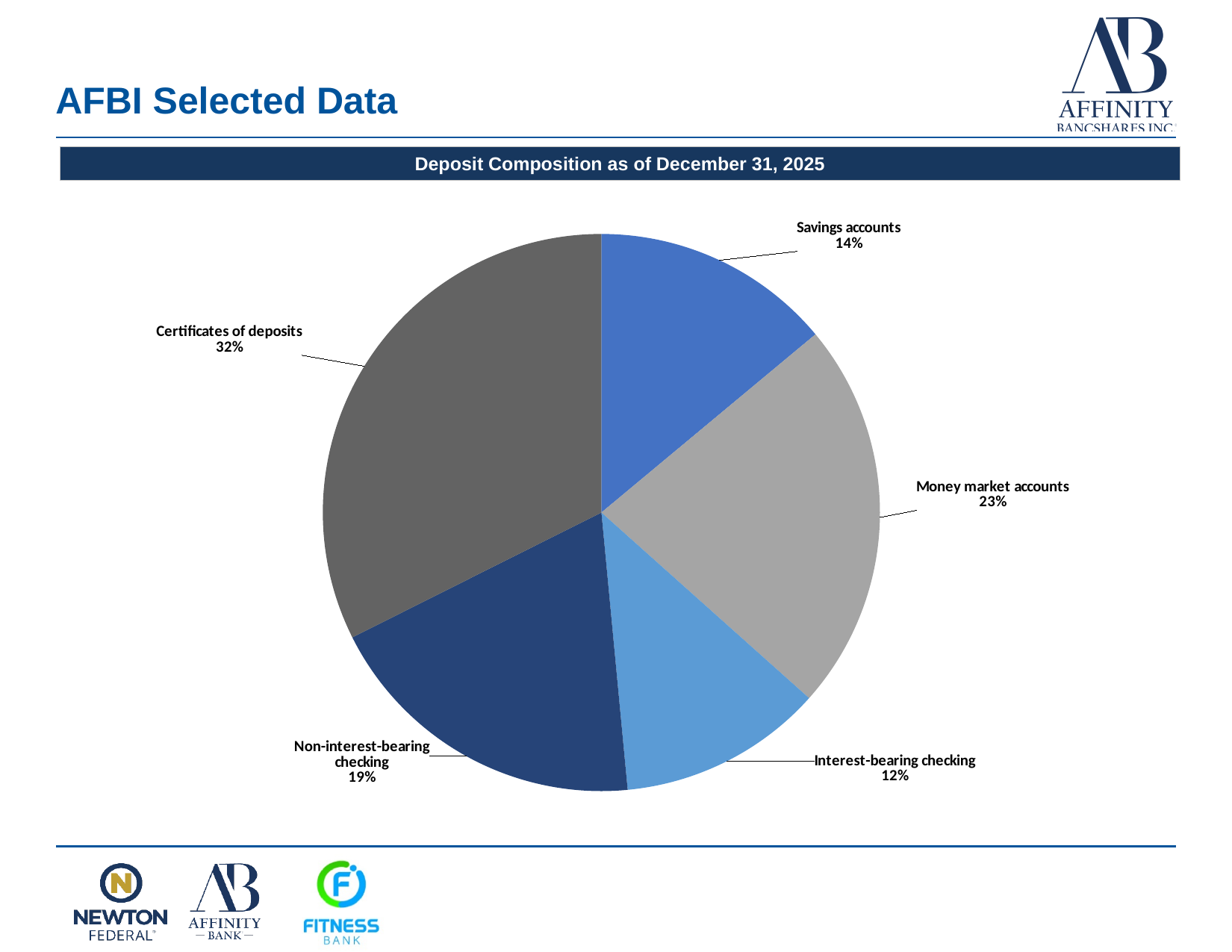
What is the difference in percentage points between certificates of deposits and money market accounts? 9 What type of chart is shown on the slide? Pie chart What share of deposits is in savings accounts? 14% What share of deposits is in interest-bearing checking? 12% What is the title of the chart? Deposit Composition as of December 31, 2025 What share of deposits is in money market accounts? 23% Which is larger, the share for non-interest-bearing checking or the share for savings accounts? Non-interest-bearing checking Which deposit category has the largest share? Certificates of deposits Which deposit category has the smallest share? Interest-bearing checking How many deposit categories are shown in the pie chart? 5 What share of deposits is in certificates of deposits? 32% What share of deposits is in non-interest-bearing checking? 19%